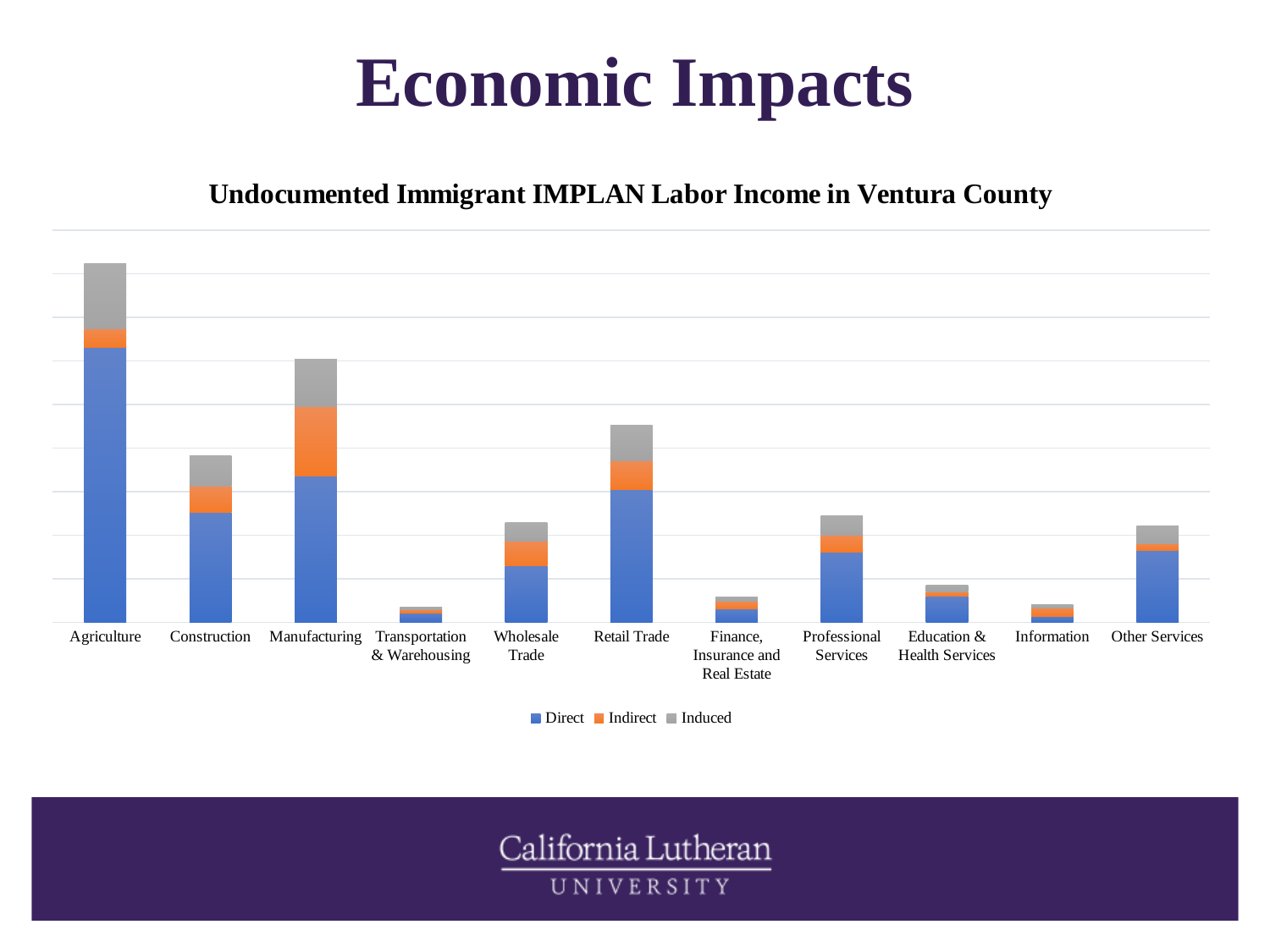
Which industry has the highest total labor income? Agriculture What is the title of the chart? Undocumented Immigrant IMPLAN Labor Income in Ventura County Which industry has the largest Induced segment? Agriculture What are the three series listed in the legend? Direct, Indirect, Induced How many industry categories are shown on the x axis? 11 Which has a larger total, Other Services or Education & Health Services? Other Services What type of chart is shown on the slide? Stacked bar chart Which has a larger total, Retail Trade or Construction? Retail Trade Which industry has the largest Indirect segment? Manufacturing How many series does the legend list? 3 Which has a larger total, Manufacturing or Retail Trade? Manufacturing